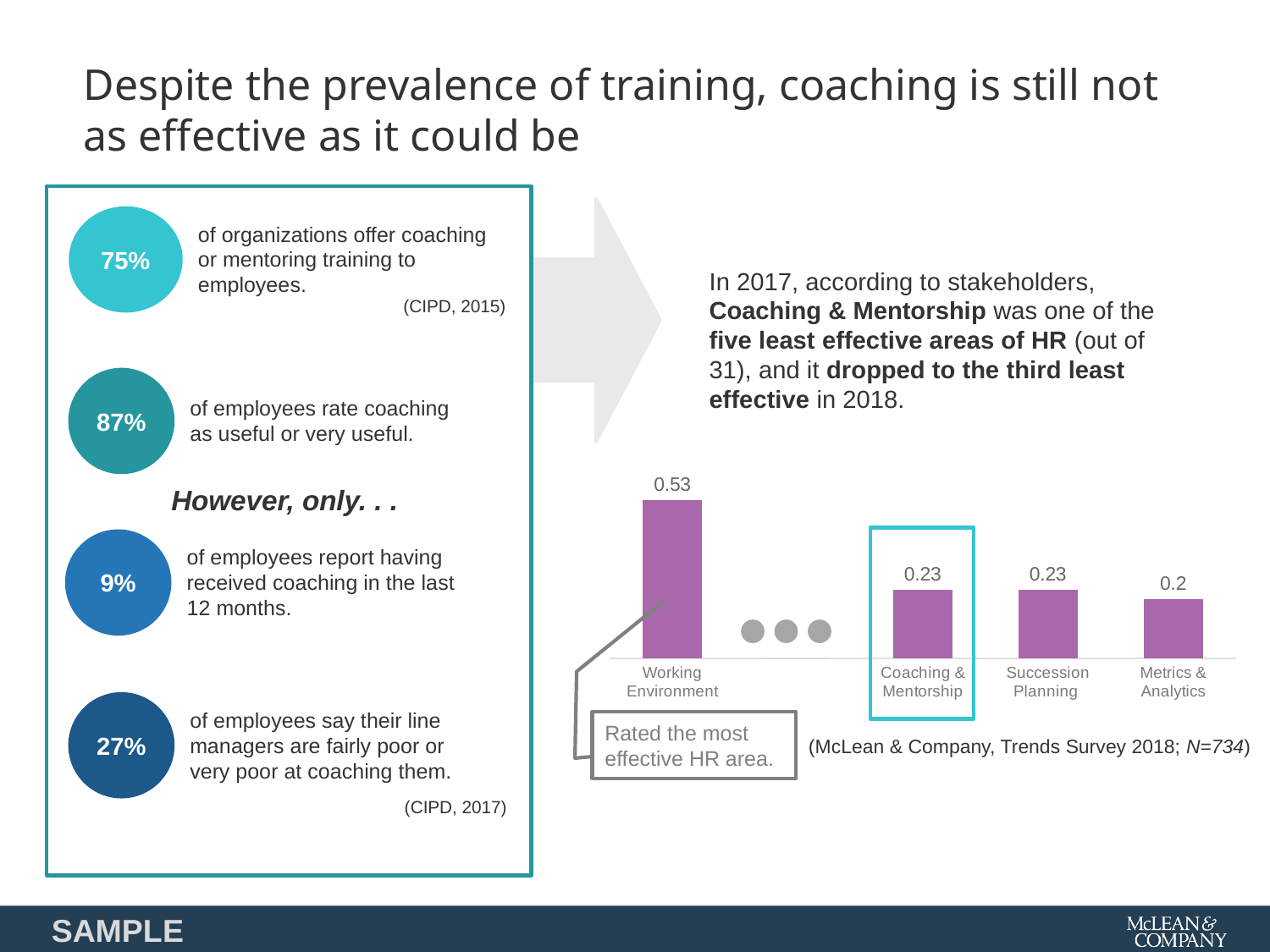
Which category has the highest value in the bar chart? Working Environment Which category in the bar chart is highlighted with a teal outline box? Coaching & Mentorship What is the difference between the values for Succession Planning and Metrics & Analytics? 0.03 What is the value for Working Environment in the bar chart? 0.53 Which is larger, the value for Working Environment or the value for Succession Planning? Working Environment What is the difference between the values for Working Environment and Coaching & Mentorship? 0.3 How many labelled categories are shown in the bar chart? 4 What is the value for Metrics & Analytics in the bar chart? 0.2 What is the value for Coaching & Mentorship in the bar chart? 0.23 What is the value for Succession Planning in the bar chart? 0.23 Which category has the lowest value among the bars shown in the chart? Metrics & Analytics What kind of chart is shown on the slide? Bar chart